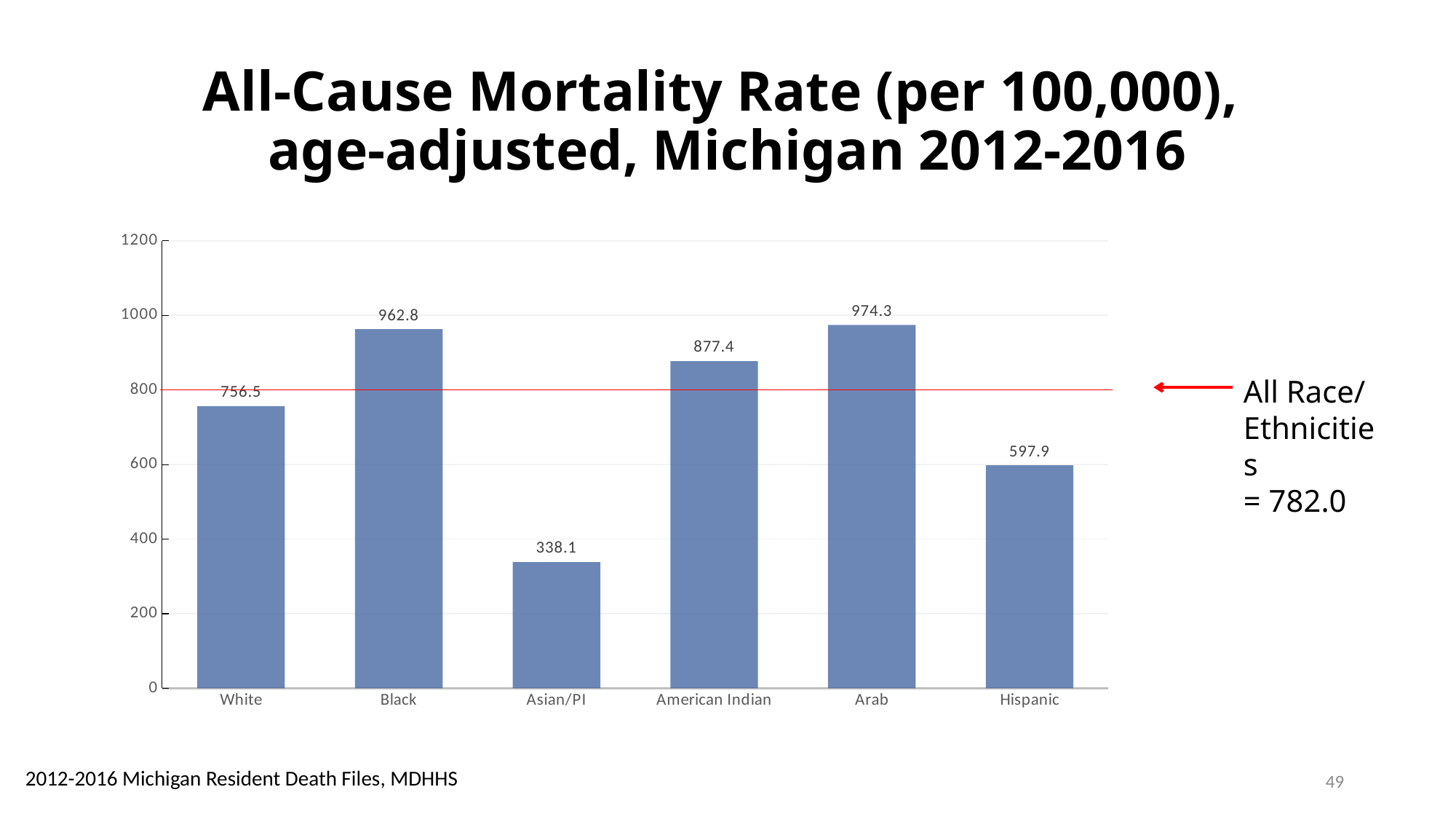
What is the all-cause mortality rate for all race/ethnicities combined, as indicated by the horizontal line? 782.0 Which race/ethnicity group has the highest all-cause mortality rate? Arab What is the difference between the mortality rates for Black and Hispanic residents? 364.9 What is the all-cause mortality rate for Black residents? 962.8 What is the difference between the mortality rates for Arab and White residents? 217.8 What is the all-cause mortality rate for Hispanic residents? 597.9 Which group has a higher mortality rate, American Indian or Hispanic? American Indian Is the value for White greater or less than 800? less How many race/ethnicity categories are shown on the chart? 6 What is the all-cause mortality rate for Asian/PI residents? 338.1 What kind of chart is shown on the slide? bar chart Which race/ethnicity group has the lowest all-cause mortality rate? Asian/PI